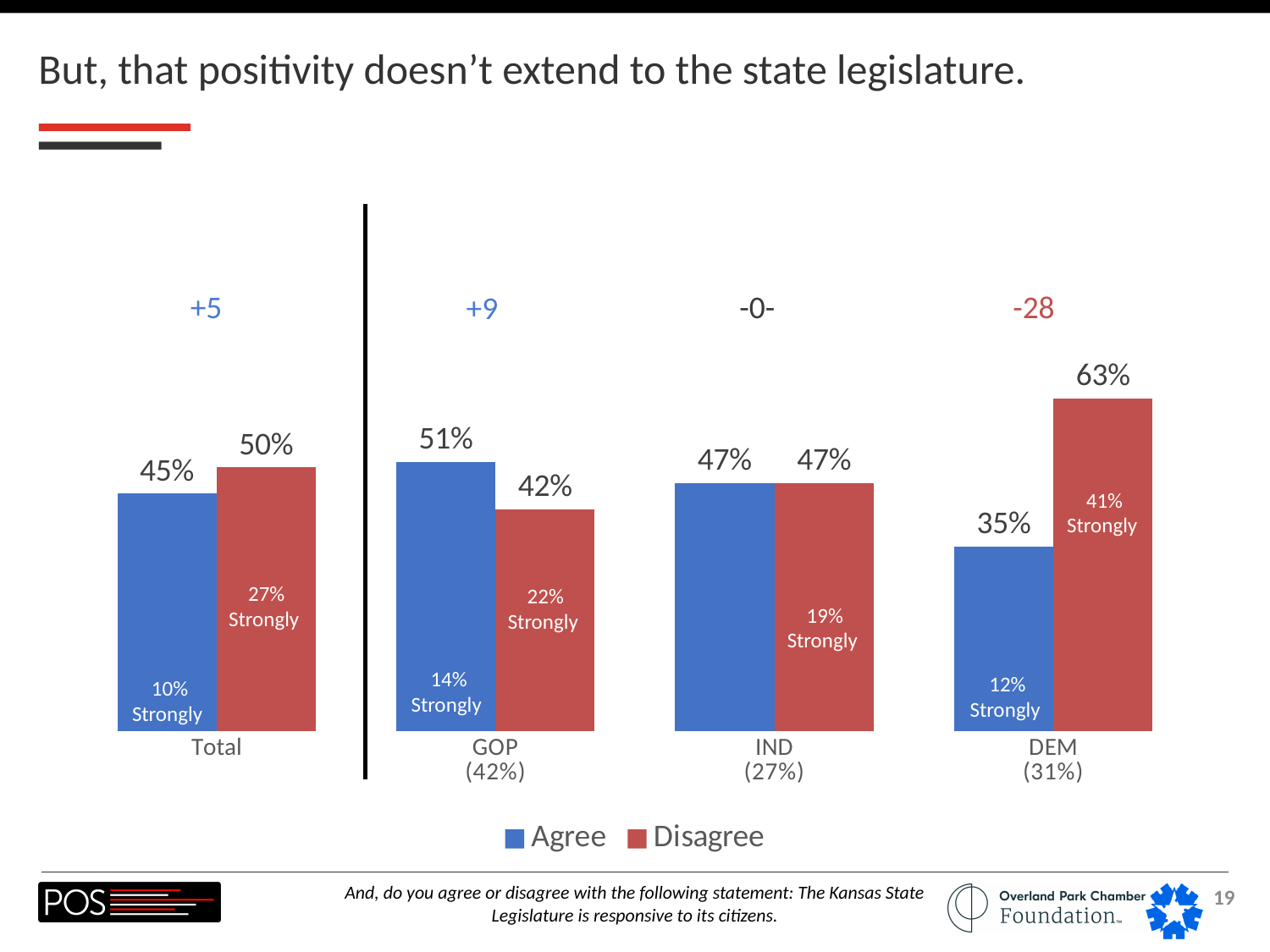
What is the Agree value for GOP? 51% What percentage of IND respondents strongly disagree? 19% What is the difference between the Disagree and Agree values for DEM? 28 What percentage of Total respondents agree that the Kansas State Legislature is responsive to its citizens? 45% What is the Disagree value for DEM? 63% Which group has the lowest Agree value? DEM What net score is printed above the DEM bars? -28 Which group has the highest Disagree value? DEM How many groups are shown on the x axis of the chart? 4 For GOP, which is larger: Agree or Disagree? Agree What kind of chart is shown on the slide? Bar chart How many series does the legend list? 2